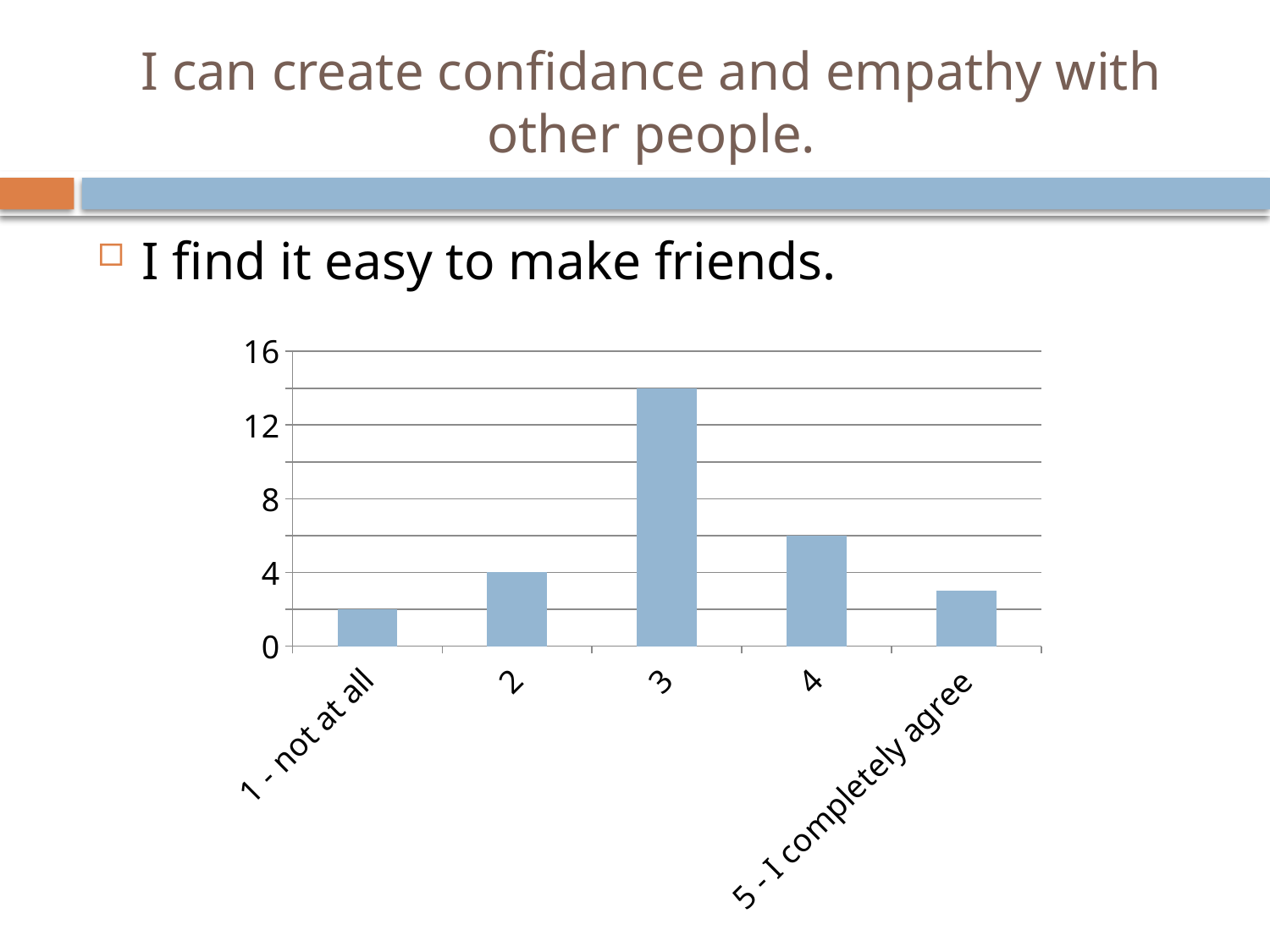
What kind of chart is shown on the slide? bar chart What is the value for category 2? 4 How many categories are shown on the x axis of the chart? 5 Is the value for '5 - I completely agree' greater or less than 4? less Is the value for category 4 greater or less than 4? greater Is the value for category 3 greater or less than 12? greater Which category has the lowest value in the chart? 1 - not at all Which category has the highest value in the chart? 3 Do the values rise or fall from category 3 to '5 - I completely agree'? fall Which has the larger value, category 4 or '5 - I completely agree'? 4 What colour are the bars in the chart? blue